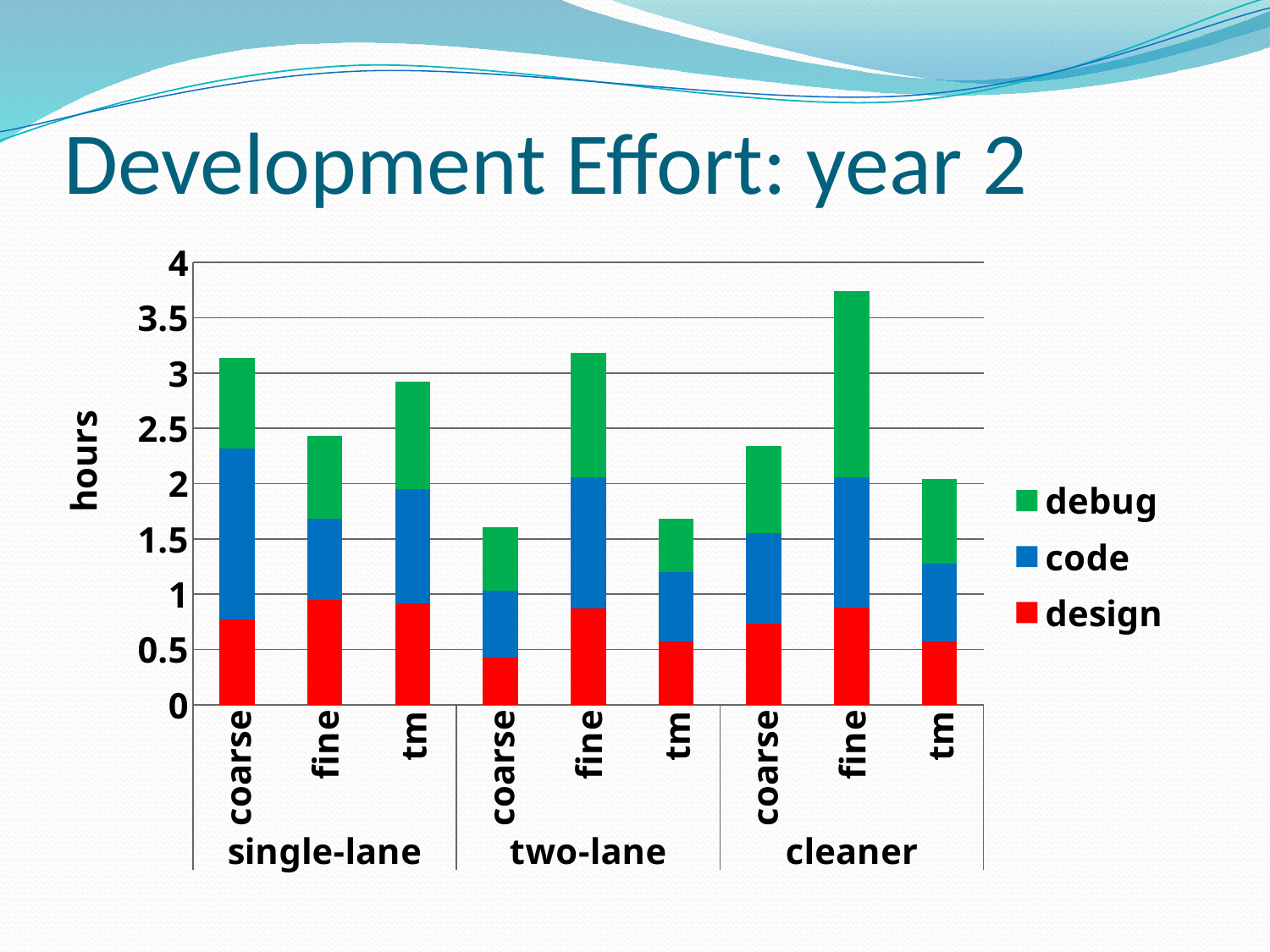
Which bar has the highest total hours? cleaner fine Is the total for single-lane coarse greater or less than 3 hours? greater Is the total for cleaner fine greater or less than 3.5 hours? greater What is the label on the vertical axis? hours What kind of chart is shown on the slide? stacked bar chart Which has the larger total: single-lane coarse or single-lane fine? single-lane coarse How many bars are plotted in the chart? 9 Is the total for two-lane coarse greater or less than 2 hours? less Within the single-lane group, which bar has the lowest total hours? fine Which has the larger total: two-lane fine or two-lane tm? two-lane fine How many series does the legend list? 3